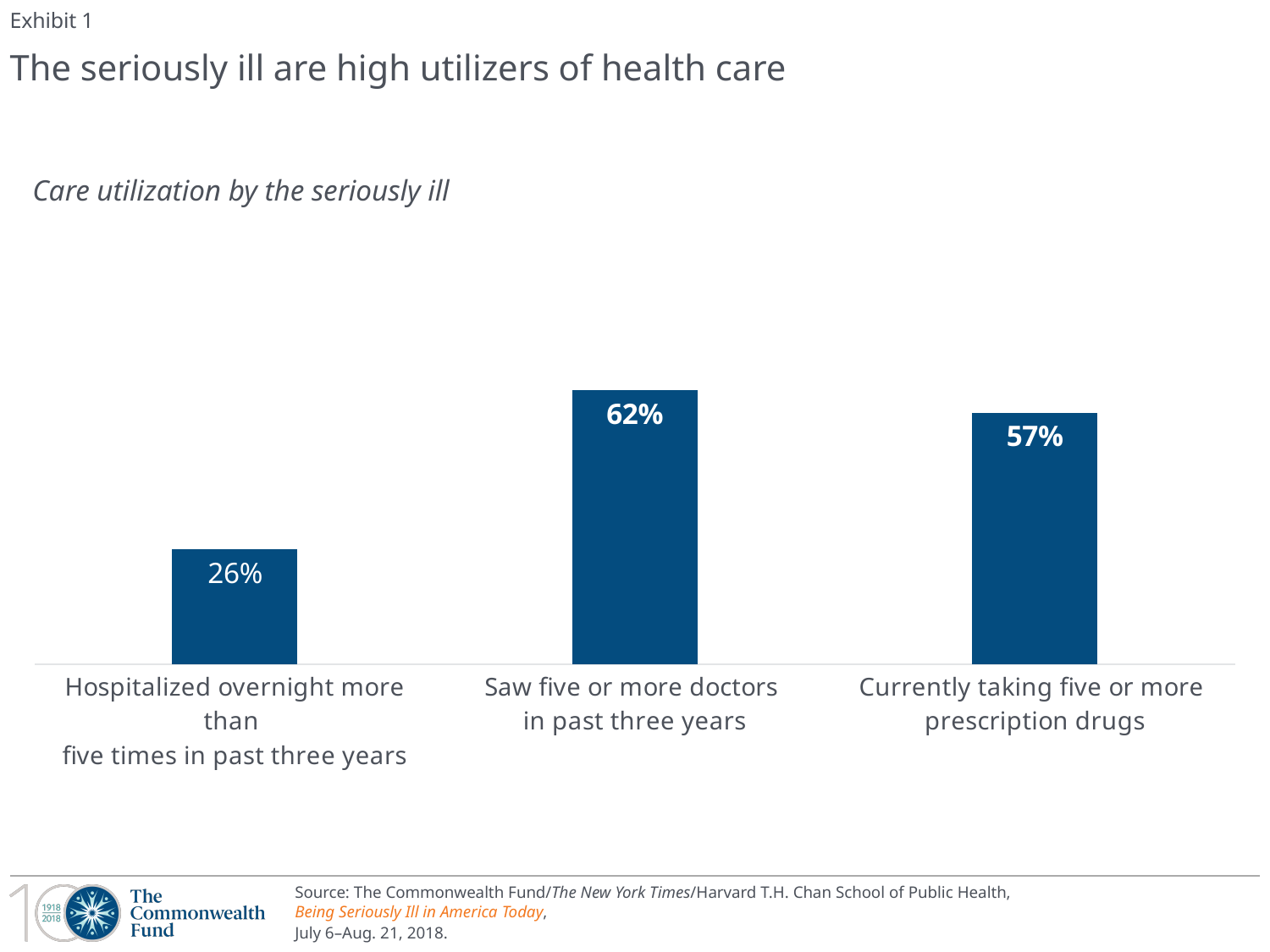
Which is larger: the share currently taking five or more prescription drugs or the share hospitalized overnight more than five times? Currently taking five or more prescription drugs What is the subtitle of the chart? Care utilization by the seriously ill Which category has the highest value in the chart? Saw five or more doctors in past three years How many categories are shown in the chart? 3 What percentage of the seriously ill saw five or more doctors in the past three years? 62% What is the difference between the share who saw five or more doctors and the share hospitalized overnight more than five times? 36 percentage points What is the difference between the share who saw five or more doctors and the share currently taking five or more prescription drugs? 5 percentage points Which category has the lowest value in the chart? Hospitalized overnight more than five times in past three years What percentage of the seriously ill are currently taking five or more prescription drugs? 57% What kind of chart is shown on the slide? Bar chart What percentage of the seriously ill were hospitalized overnight more than five times in the past three years? 26% What colour are the bars in the chart? Dark blue